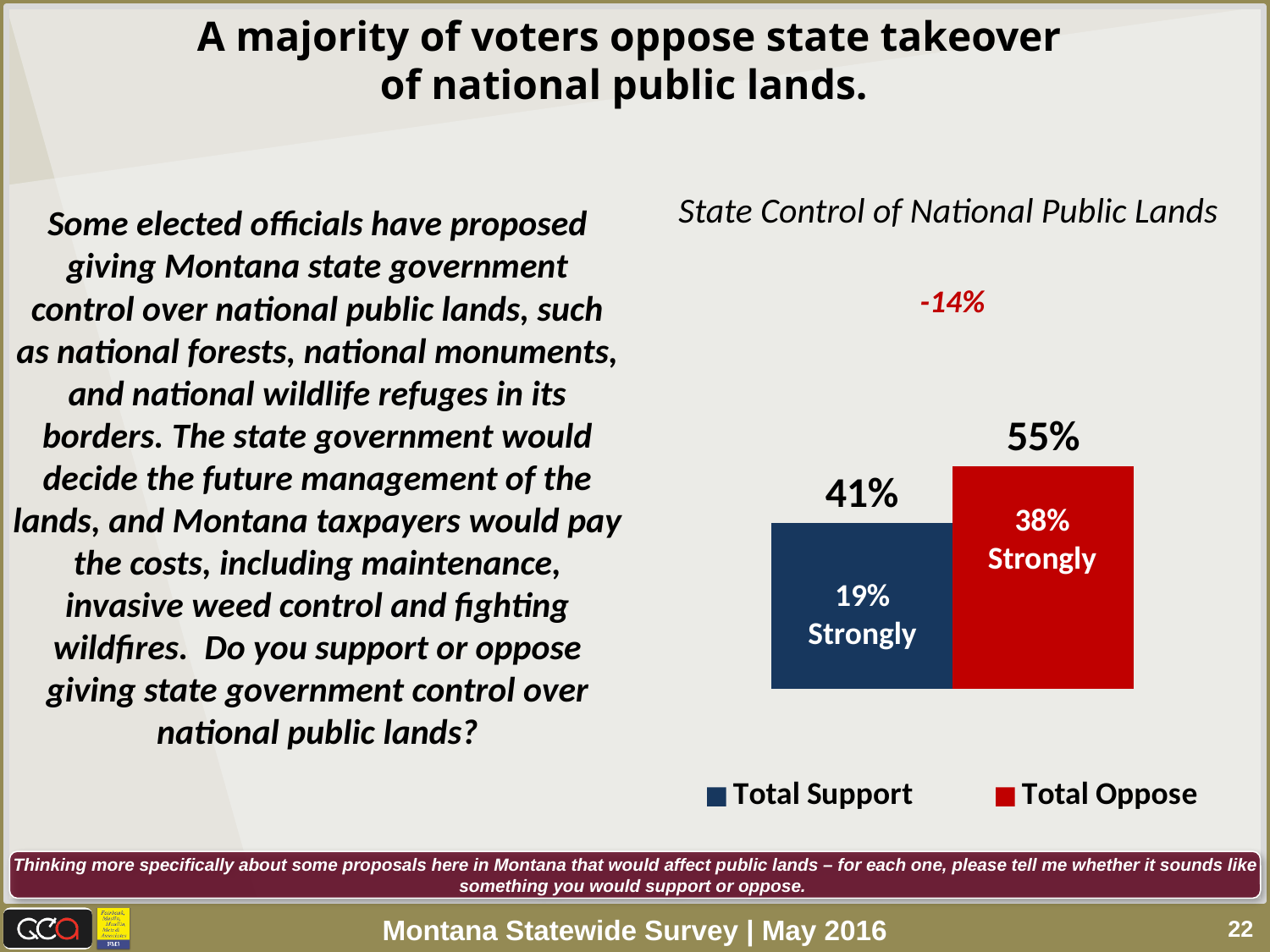
What net figure is printed in red above the bars? -14% What is the value for Total Oppose in the State Control of National Public Lands chart? 55% What is the difference between Total Oppose and Total Support? 14% What percentage strongly oppose state control of national public lands? 38% What is the title of the chart? State Control of National Public Lands What kind of chart is shown on the slide? Bar chart What percentage strongly support state control of national public lands? 19% How many series does the legend list? 2 Which series has the lowest total value in the chart? Total Support What is the difference between the Strongly Oppose and Strongly Support values? 19% What is the value for Total Support in the State Control of National Public Lands chart? 41% Which series has the higher value, Total Support or Total Oppose? Total Oppose